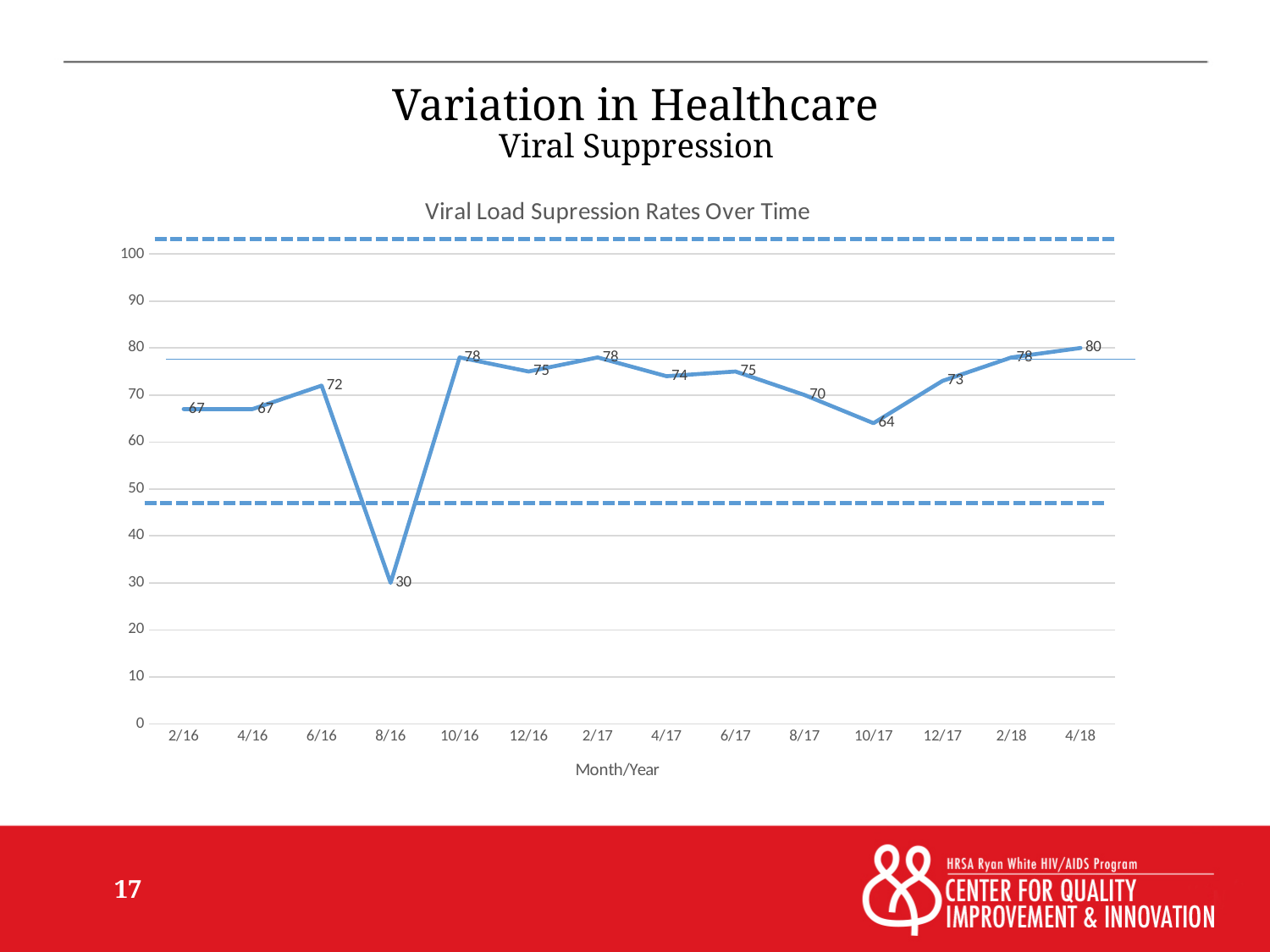
What is the difference between the rates for 6/16 and 8/16? 42 Which month/year has the highest viral load suppression rate? 4/18 What is the viral load suppression rate for 4/18? 80 How many data points are plotted on the line? 14 What is the viral load suppression rate for 10/17? 64 What is the chart's title? Viral Load Supression Rates Over Time What is the label of the x axis? Month/Year Which month/year has the lowest viral load suppression rate? 8/16 Is the value for 8/16 greater or less than 40? less What type of chart is shown on the slide? line chart What is the viral load suppression rate for 8/16? 30 Which has a higher rate, 12/16 or 10/17? 12/16